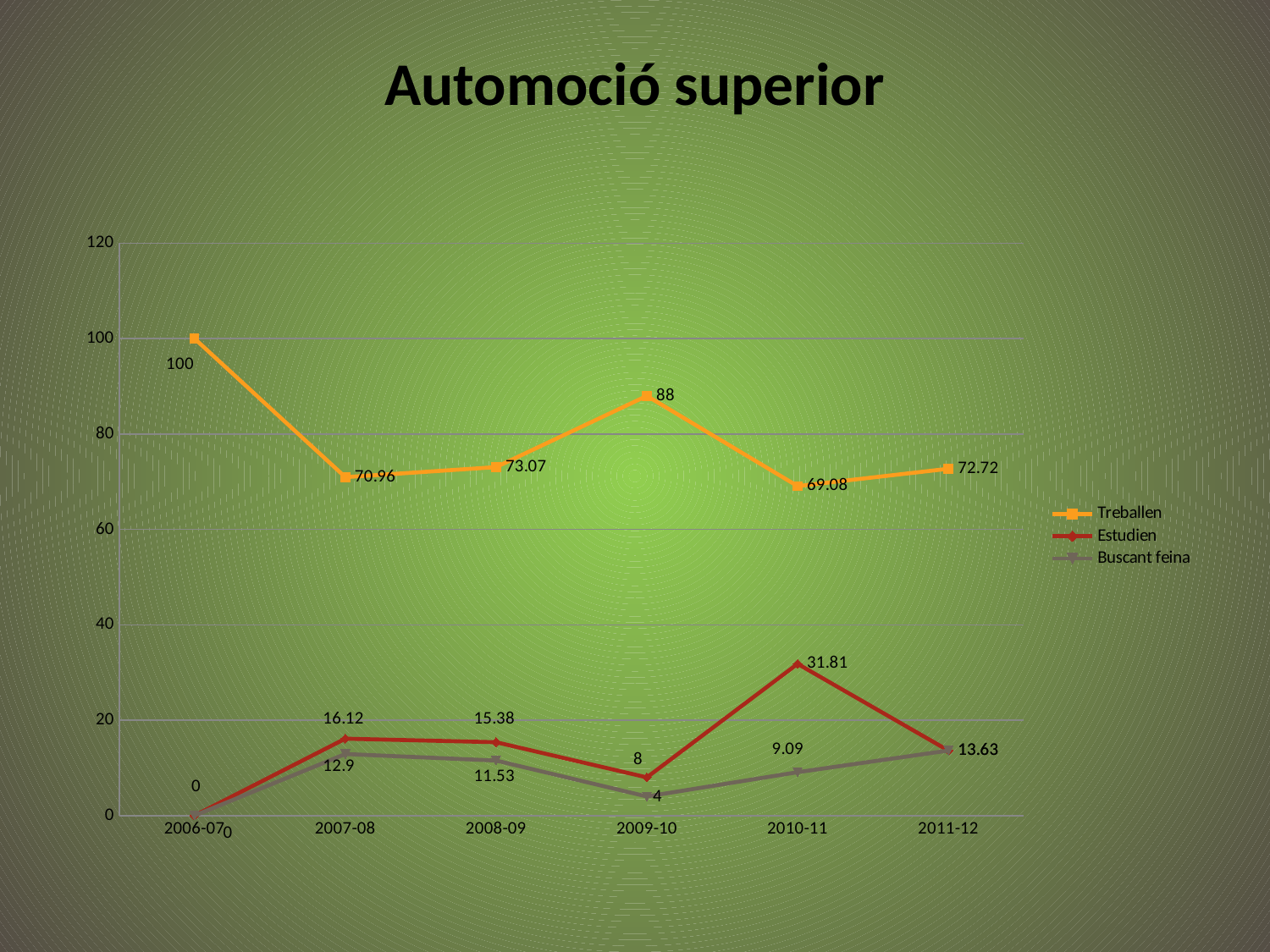
In which year is the Estudien series highest? 2010-11 In which year is the Treballen series lowest? 2010-11 How many years are shown on the x axis? 6 What is the difference between the Treballen values for 2006-07 and 2007-08? 29.04 How many series does the legend list? 3 What kind of chart is shown on the slide? line chart What is the value for Estudien in 2010-11? 31.81 What is the value for Treballen in 2009-10? 88 In which year is the Treballen series highest? 2006-07 What is the value for Buscant feina in 2008-09? 11.53 What is the value for Treballen in 2006-07? 100 In 2007-08, which is larger: Estudien or Buscant feina? Estudien